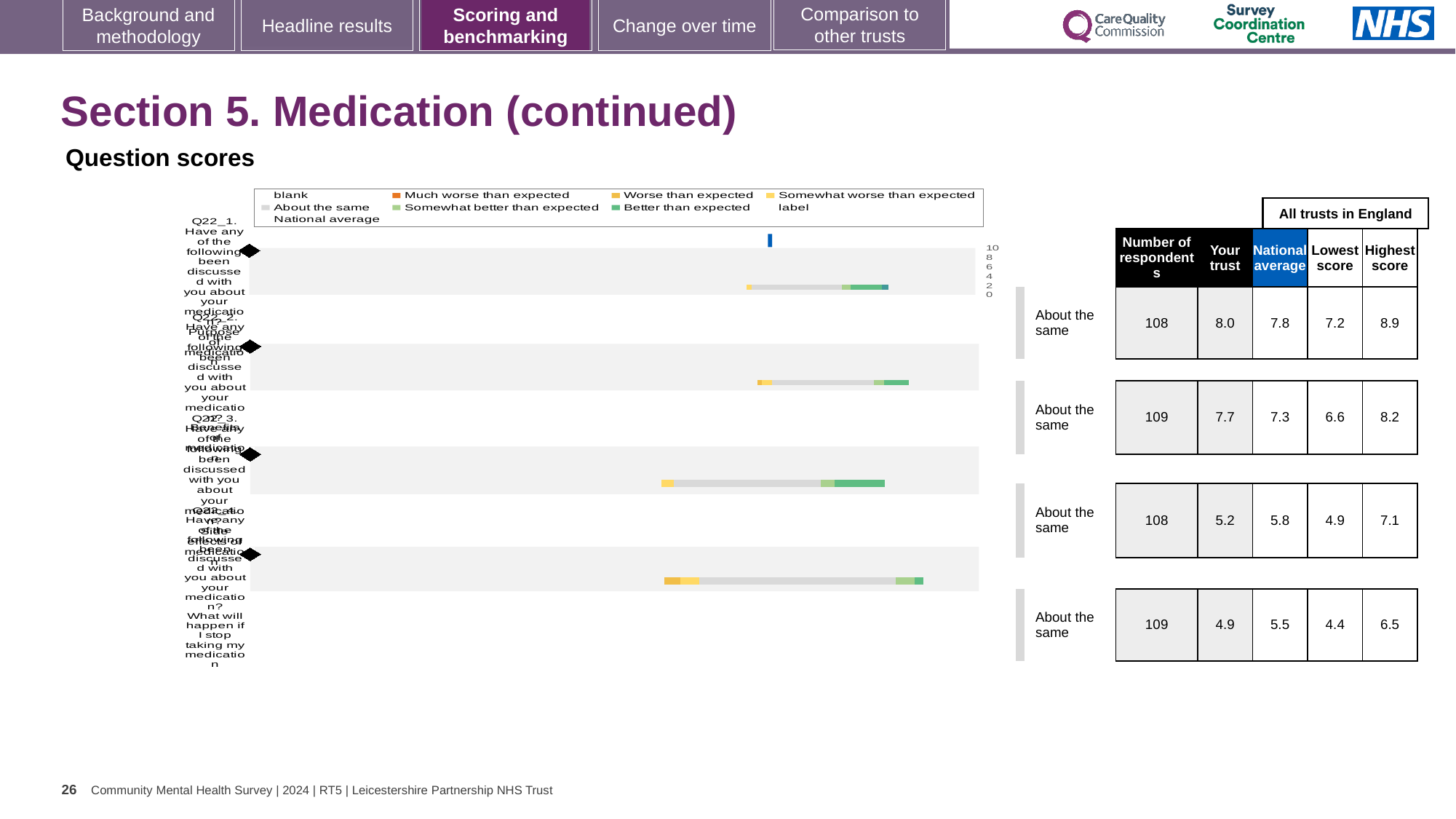
Which question row has the lowest 'Your trust' score in the table beside the chart? Q22_4 What colour does the legend use for 'Better than expected'? green Which question row has the highest 'Your trust' score in the table beside the chart? Q22_1 What is the difference between the 'Your trust' score and the national average for the first question row (Q22_1)? 0.2 What benchmark category is shown for every question row in the chart? About the same What is the highest tick value shown on the chart's score axis? 10 In the table beside the chart, what is the national average for the second question row (Q22_2)? 7.3 In the table beside the chart, what is the highest score for the fourth question row (Q22_4)? 6.5 How many question rows (Q22_1 to Q22_4) are plotted in the chart? 4 In the table beside the chart, what is the number of respondents for the third question row (Q22_3)? 108 In the table beside the chart, what is the 'Your trust' score for the first question row (Q22_1)? 8.0 What kind of chart is shown under 'Question scores'? bar chart